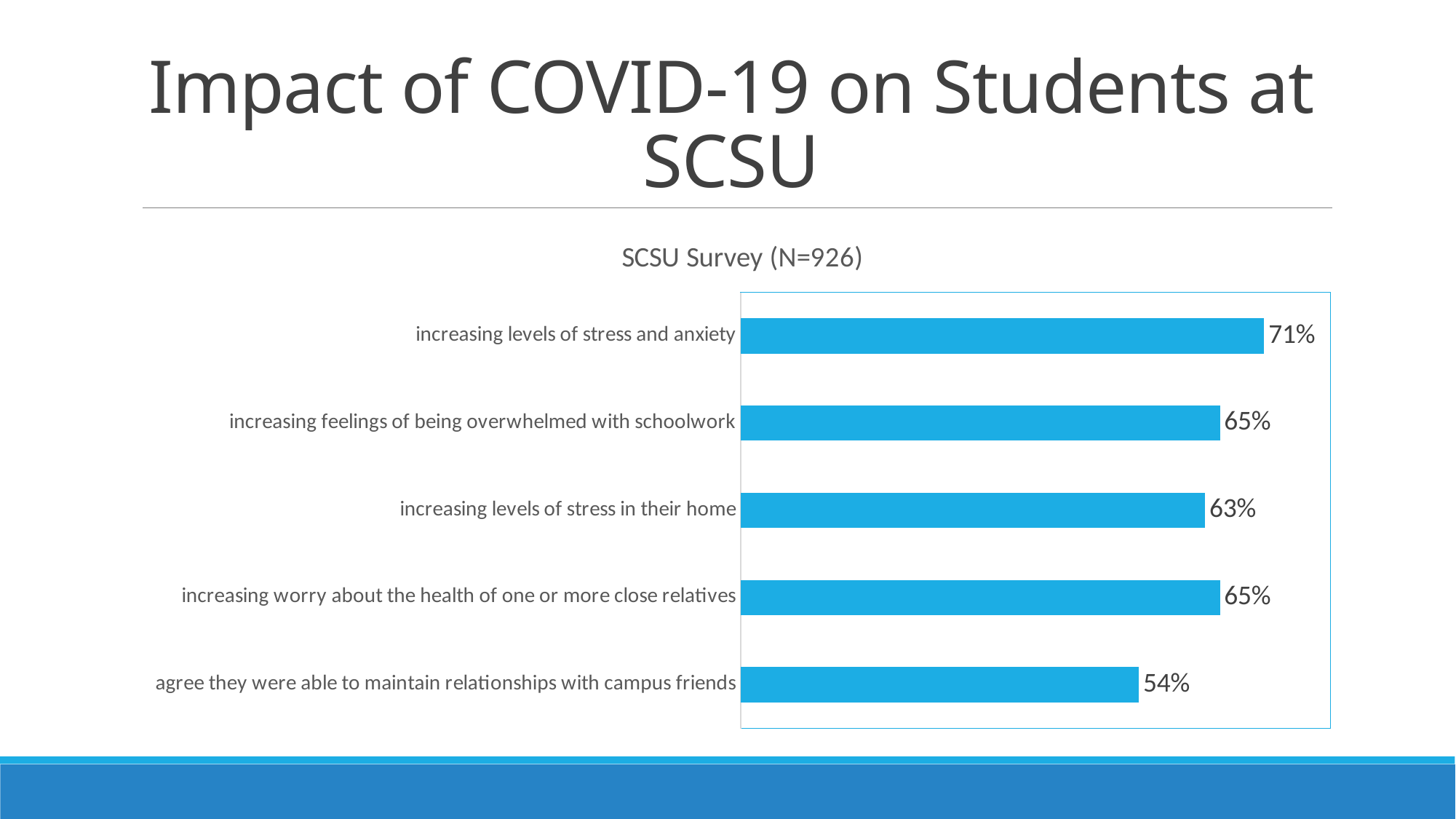
What is the value for 'increasing worry about the health of one or more close relatives'? 65% What is the title of the chart? SCSU Survey (N=926) What is the value for 'agree they were able to maintain relationships with campus friends'? 54% Which category has the highest value? increasing levels of stress and anxiety What is the difference between the value for increasing levels of stress and anxiety and the value for agree they were able to maintain relationships with campus friends? 17% What percentage of students reported increasing levels of stress and anxiety? 71% What kind of chart is shown on the slide? bar chart Which is larger: the value for increasing levels of stress in their home or the value for agree they were able to maintain relationships with campus friends? increasing levels of stress in their home Which category has the lowest value? agree they were able to maintain relationships with campus friends What percentage reported increasing levels of stress in their home? 63% What is the difference between the value for increasing feelings of being overwhelmed with schoolwork and the value for increasing levels of stress in their home? 2% How many categories are shown in the chart? 5